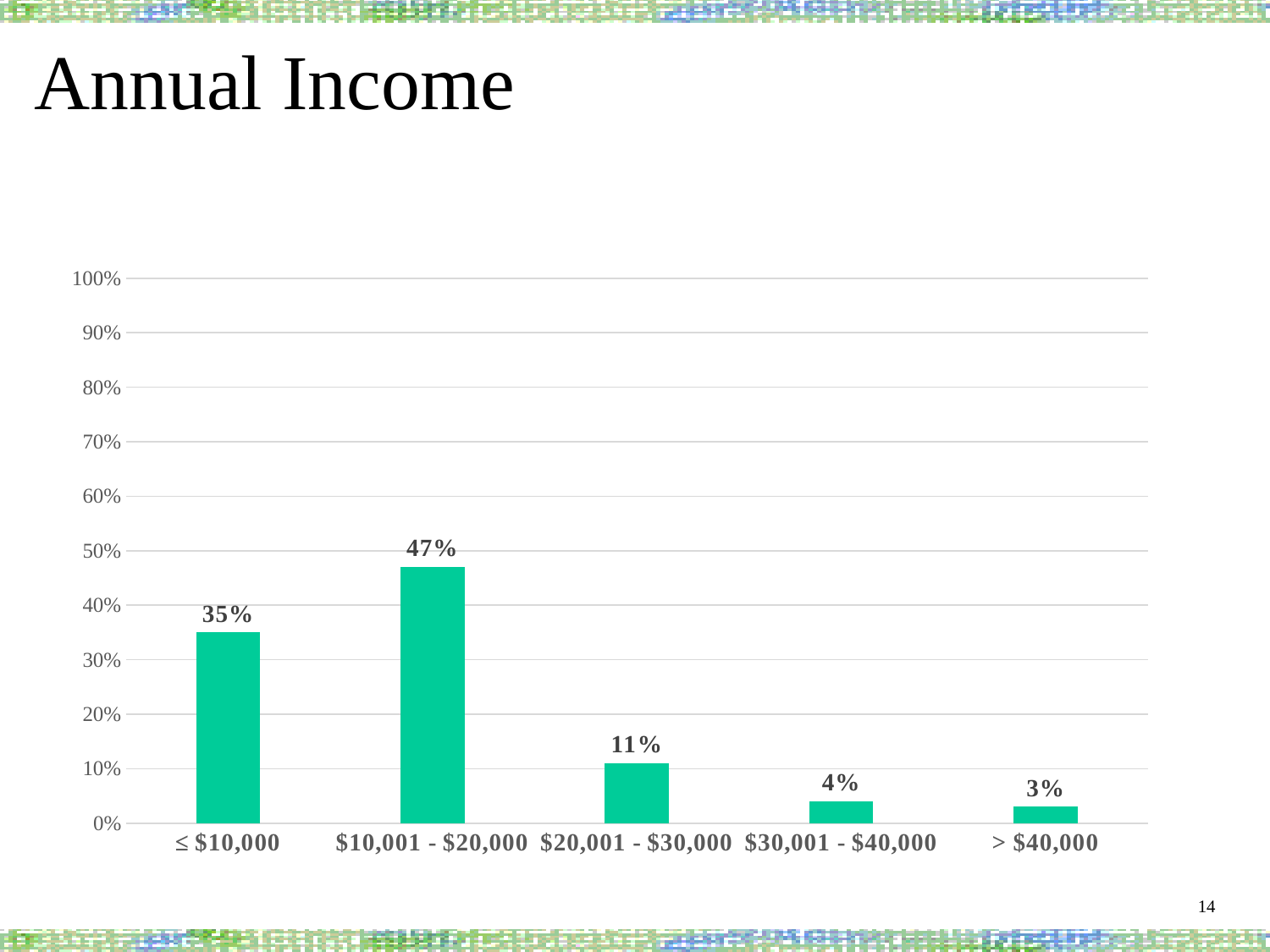
How many income categories are shown on the chart? 5 Which is larger, the value for ≤ $10,000 or the value for $20,001 - $30,000? ≤ $10,000 Is the value for $10,001 - $20,000 greater or less than 50%? less What is the difference in percentage points between the $10,001 - $20,000 and ≤ $10,000 categories? 12 Which income category has the lowest percentage? > $40,000 What is the title of the slide? Annual Income What is the value shown for the ≤ $10,000 income category? 35% What type of chart is shown on the slide? bar chart What percentage is shown for the > $40,000 category? 3% What is the difference between the $20,001 - $30,000 and $30,001 - $40,000 values? 7 Which income category has the highest percentage? $10,001 - $20,000 What percentage of respondents have an annual income of $10,001 - $20,000? 47%